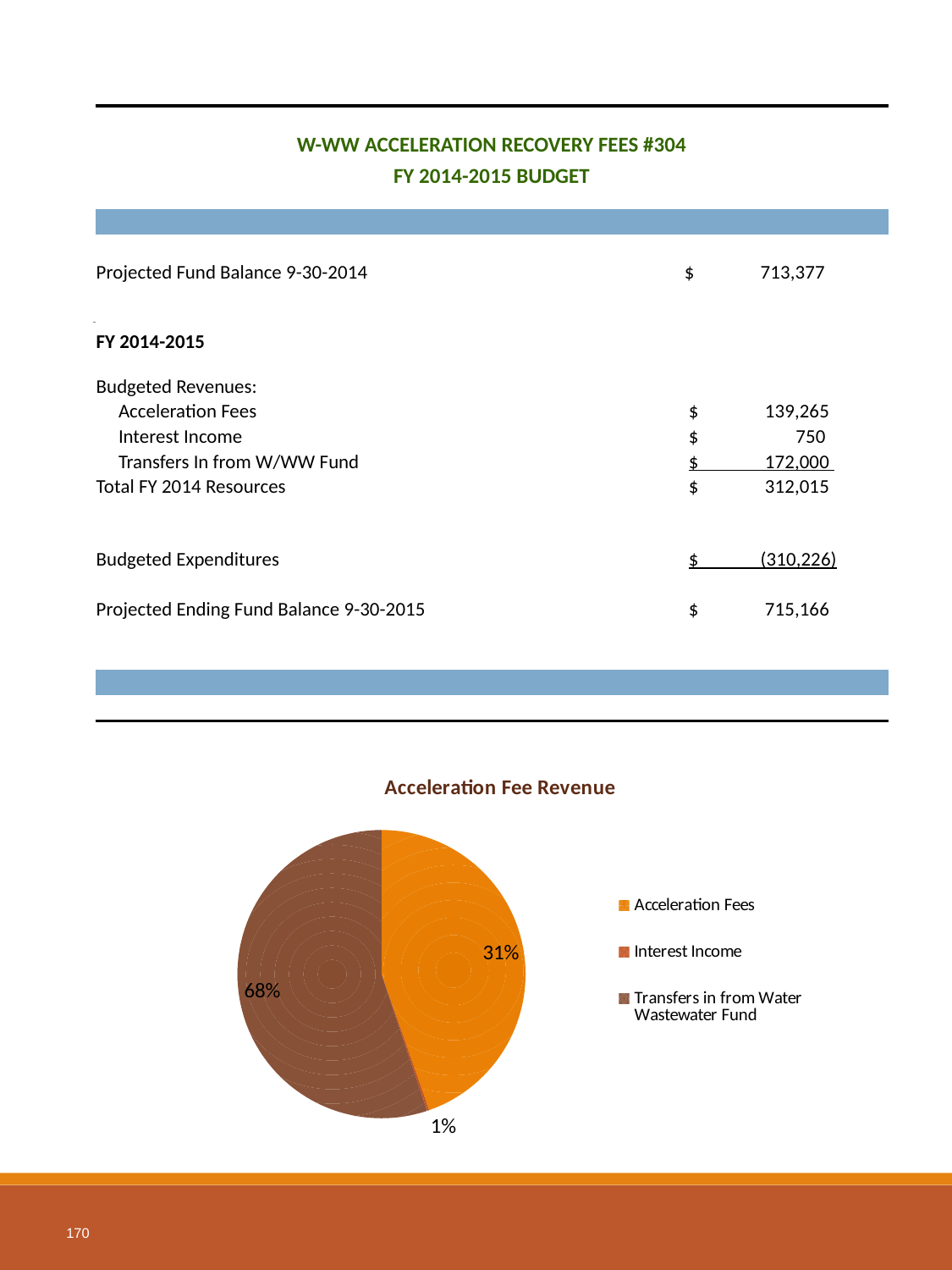
How many entries does the legend of the pie chart list? 3 What is the title of the chart on the slide? Acceleration Fee Revenue In the pie chart, what is the difference in percentage points between Transfers in from Water Wastewater Fund and Acceleration Fees? 37 percentage points In the pie chart, which is larger: Acceleration Fees or Transfers in from Water Wastewater Fund? Transfers in from Water Wastewater Fund How many slices does the pie chart have? 3 What share of the pie chart is Interest Income? 1% Which slice of the pie chart is the smallest? Interest Income What kind of chart is shown under the title "Acceleration Fee Revenue"? pie chart Which slice of the pie chart is the largest? Transfers in from Water Wastewater Fund What share of the pie chart is Acceleration Fees? 31% Which legend entry in the pie chart is shown in orange? Acceleration Fees What share of the pie chart is Transfers in from Water Wastewater Fund? 68%